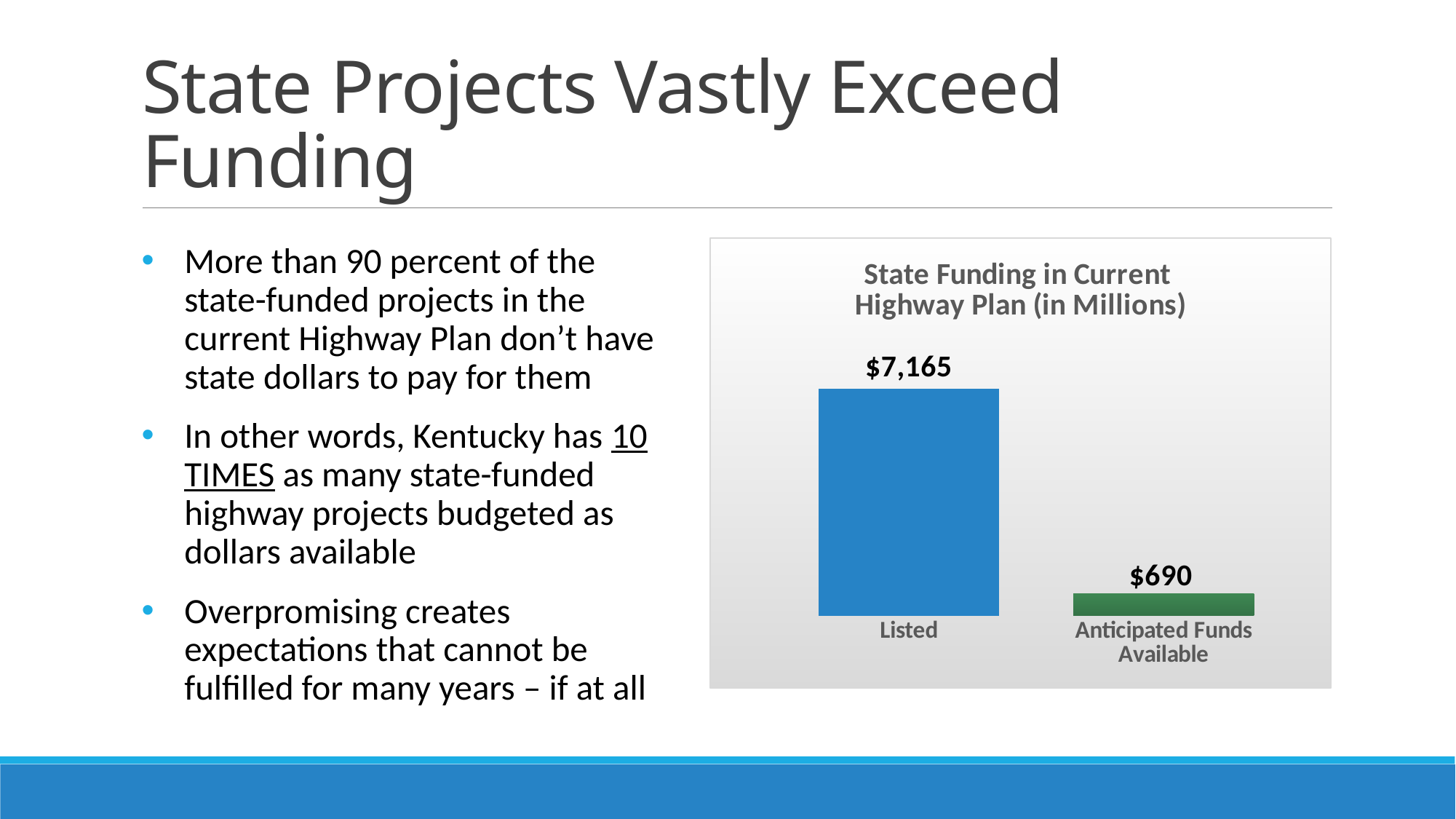
Which is larger, Listed or Anticipated Funds Available? Listed Which category has the lowest value? Anticipated Funds Available What is the value for Anticipated Funds Available? $690 How many categories are shown in the chart? 2 What kind of chart is shown on the slide? Bar chart What is the difference between the Listed value and the Anticipated Funds Available value? $6,475 What colour is the bar for Anticipated Funds Available? Green What is the value for Listed? $7,165 What is the title of the chart? State Funding in Current Highway Plan (in Millions) Which category has the highest value? Listed